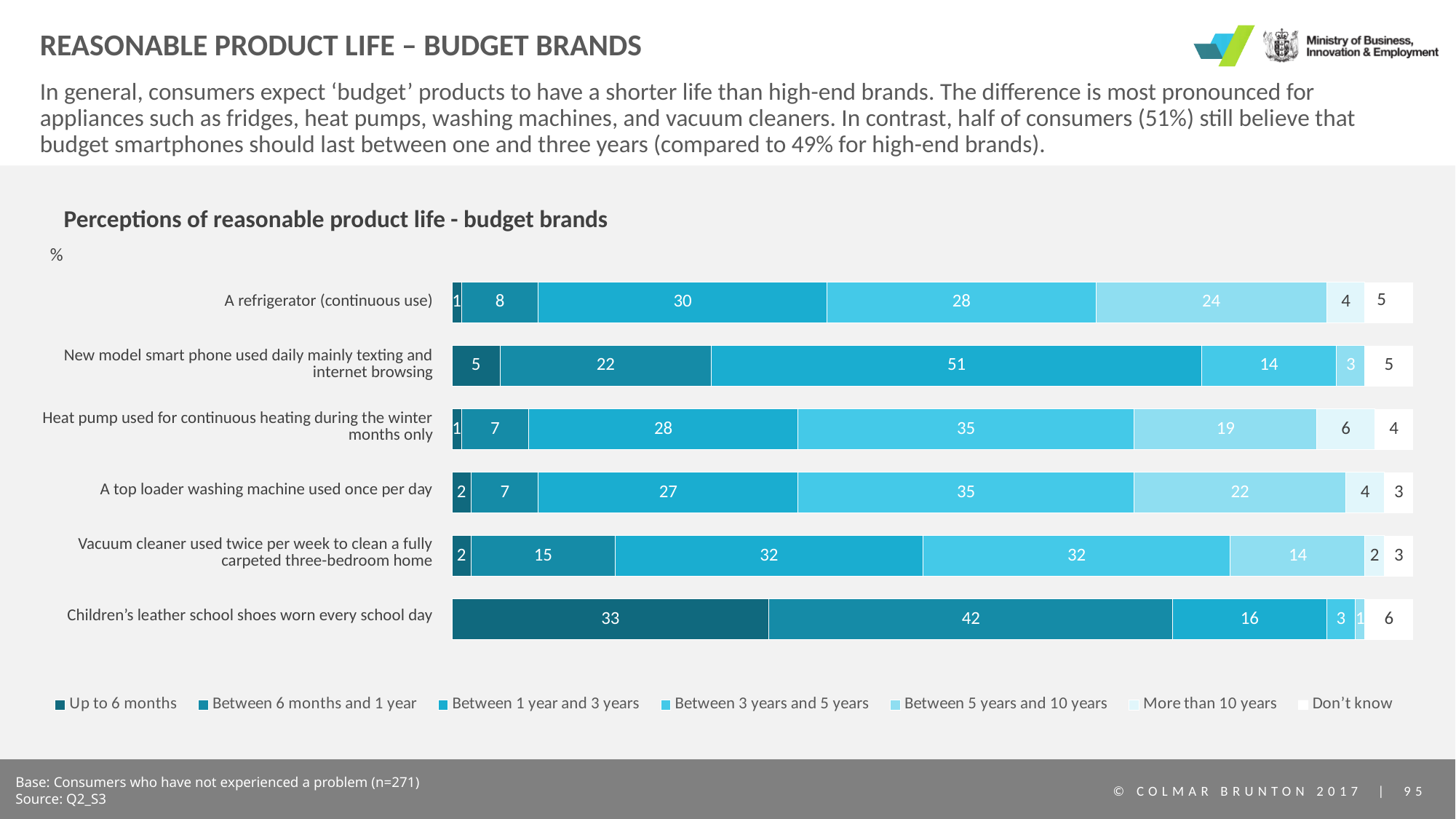
How many series does the legend list? 7 Which product has the lowest percentage for 'Between 1 year and 3 years'? Children's leather school shoes worn every school day What is the 'Don't know' percentage for children's leather school shoes worn every school day? 6 For the heat pump used for continuous heating during the winter months only, what is the difference between the 'Between 3 years and 5 years' and 'Between 1 year and 3 years' percentages? 7 Which has a larger 'Between 6 months and 1 year' percentage: the vacuum cleaner or the top loader washing machine? Vacuum cleaner used twice per week to clean a fully carpeted three-bedroom home What is the title of the chart? Perceptions of reasonable product life - budget brands What percentage of consumers think a budget new model smart phone should reasonably last between 1 year and 3 years? 51 How many products are shown in the chart? 6 What kind of chart is shown on the slide? Stacked bar chart Which product has the highest percentage for 'Up to 6 months'? Children's leather school shoes worn every school day What percentage of consumers think children's leather school shoes worn every school day should reasonably last up to 6 months? 33 What percentage of consumers think a budget refrigerator (continuous use) should reasonably last between 1 year and 3 years? 30